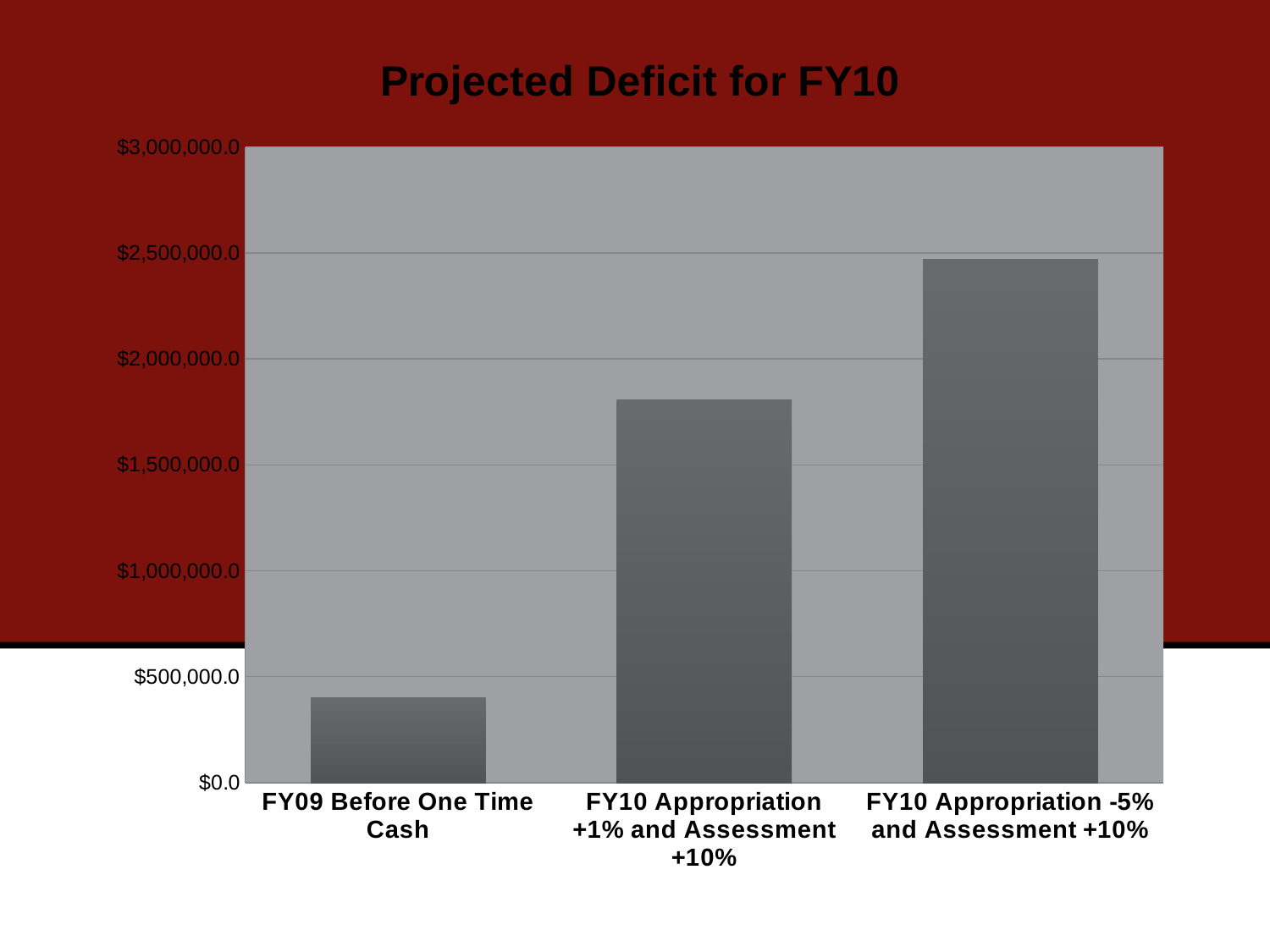
Is the value for FY09 Before One Time Cash greater or less than $500,000.0? less What kind of chart is shown on the slide? Bar chart Which category has the highest projected deficit? FY10 Appropriation -5% and Assessment +10% What is the highest value shown on the vertical axis? $3,000,000.0 Do the values rise or fall moving from left to right across the categories? Rise What is the title of the chart? Projected Deficit for FY10 Which is larger: the value for FY10 Appropriation +1% and Assessment +10% or the value for FY09 Before One Time Cash? FY10 Appropriation +1% and Assessment +10% How many categories are plotted in the chart? 3 Is the value for FY10 Appropriation +1% and Assessment +10% greater or less than $1,500,000.0? greater Which category has the lowest projected deficit? FY09 Before One Time Cash Is the value for FY10 Appropriation -5% and Assessment +10% greater or less than $2,000,000.0? greater